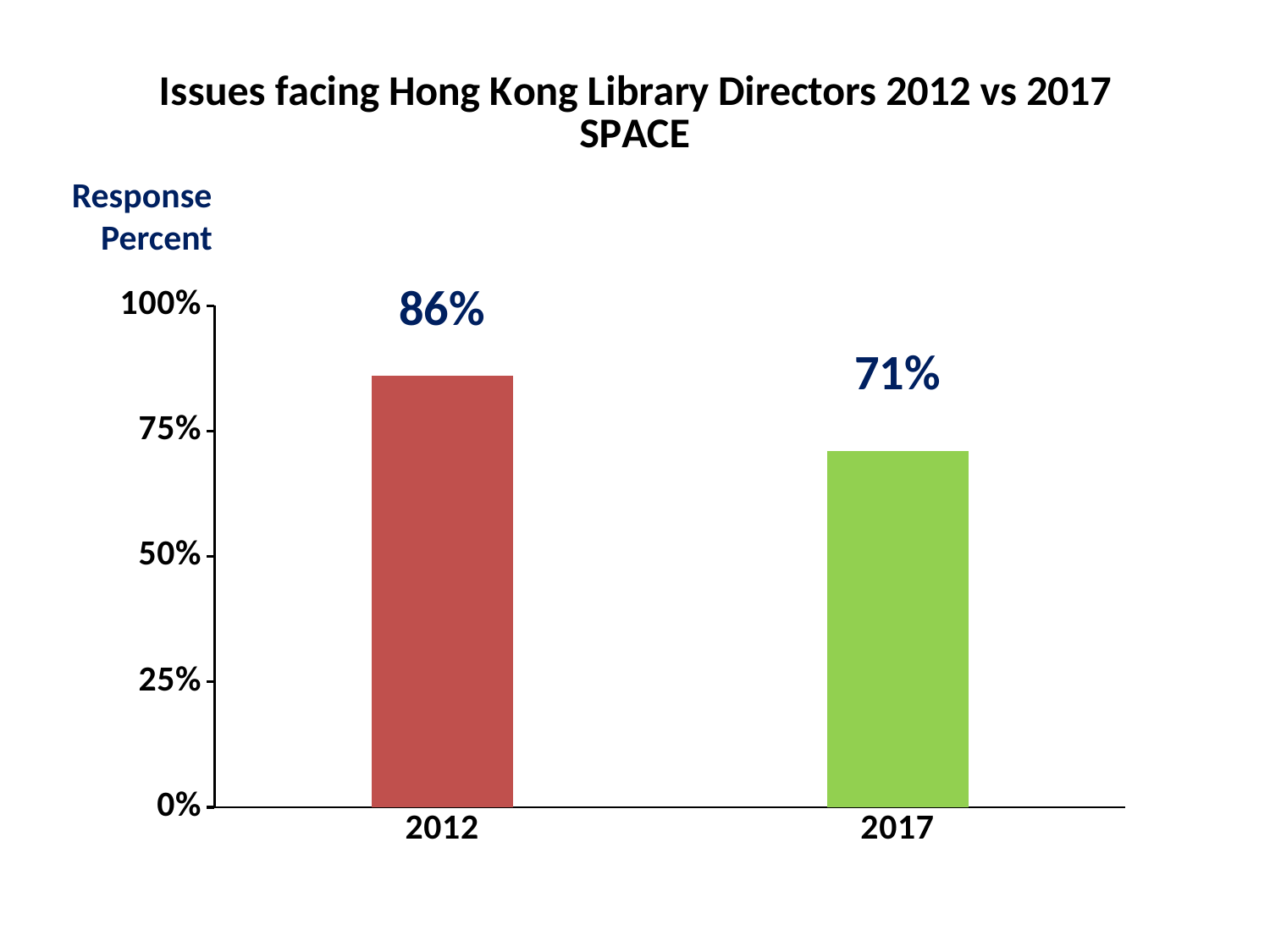
Which year has the lower response percent? 2017 Is the value for 2012 greater or less than 75%? greater Is the value for 2017 greater or less than 75%? less What is the response percent for 2012? 86% What is the title of the chart? Issues facing Hong Kong Library Directors 2012 vs 2017 SPACE Does the response percent rise or fall from 2012 to 2017? fall How many years are shown on the x axis? 2 What is the difference in response percent between 2012 and 2017? 15% What is the response percent for 2017? 71% Which year has the higher response percent? 2012 What kind of chart is shown on the slide? bar chart Is the value for 2012 larger or smaller than the value for 2017? larger